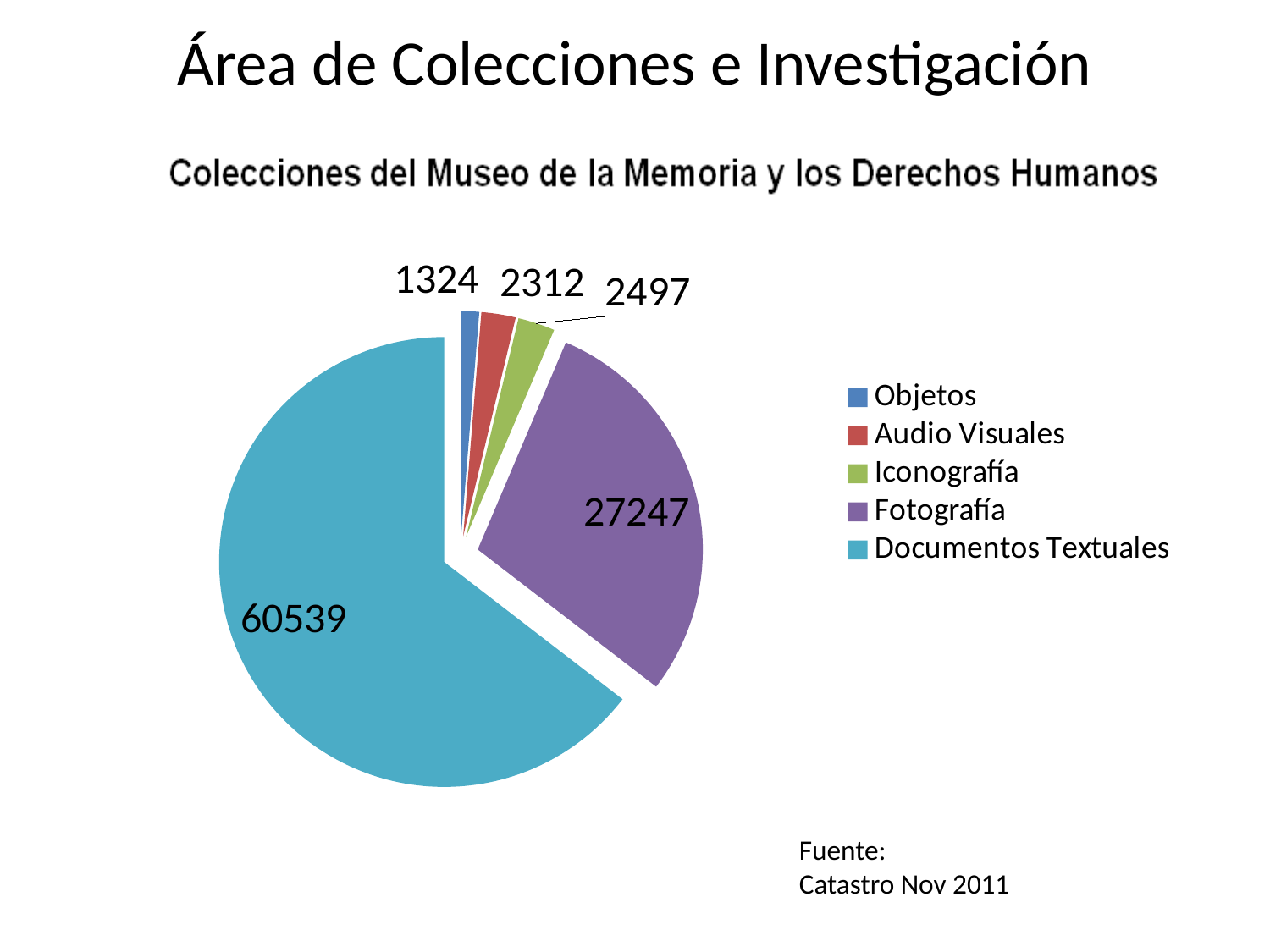
What is the value for Objetos? 1324 Which is larger, the value for Audio Visuales or the value for Iconografía? Iconografía What is the value for Iconografía? 2497 What type of chart is shown on the slide? Pie chart Which category has the largest slice of the pie? Documentos Textuales What is the total of all the values shown in the pie chart? 93919 What is the value for Documentos Textuales? 60539 What is the value for Fotografía? 27247 What is the difference between the values for Documentos Textuales and Fotografía? 33292 What is the title of the chart? Colecciones del Museo de la Memoria y los Derechos Humanos Which category has the smallest slice of the pie? Objetos How many categories does the pie chart show? 5